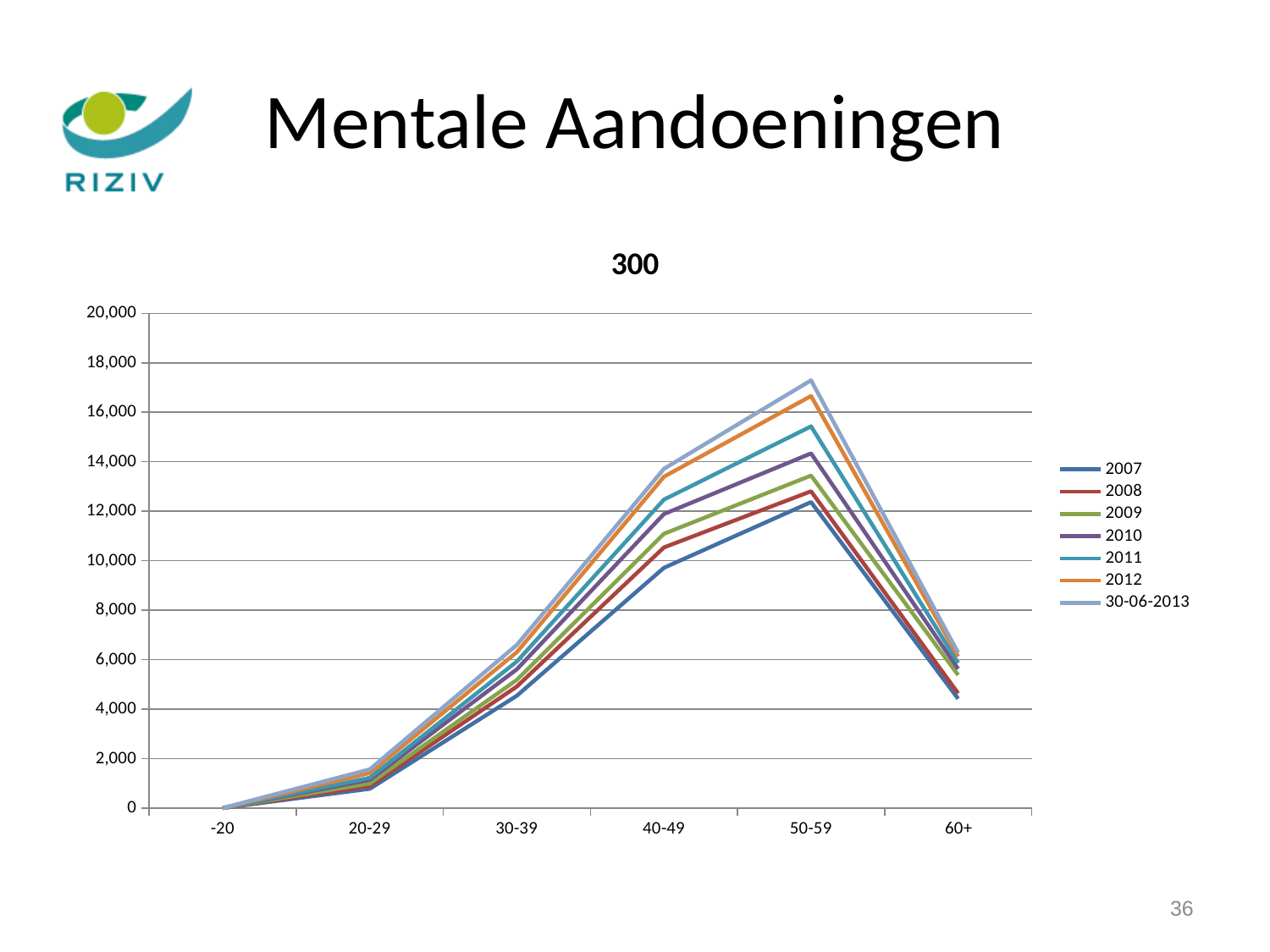
For the 2007 series, which age category has the lowest value? -20 Which series has the lowest value in the 50-59 category? 2007 Is the value for 30-06-2013 in the 50-59 category greater or less than 16,000? greater How many series does the legend list? 7 What is the title of the chart? 300 For the 30-06-2013 series, which age category has the highest value? 50-59 Which series is listed last in the legend? 30-06-2013 What kind of chart is shown on the slide? line chart How many age categories are shown on the x axis? 6 Which series has the highest value in the 50-59 category? 30-06-2013 Is the value for 2007 in the 60+ category greater or less than 6,000? less Do the values for the 2012 series rise or fall from the 50-59 category to the 60+ category? fall